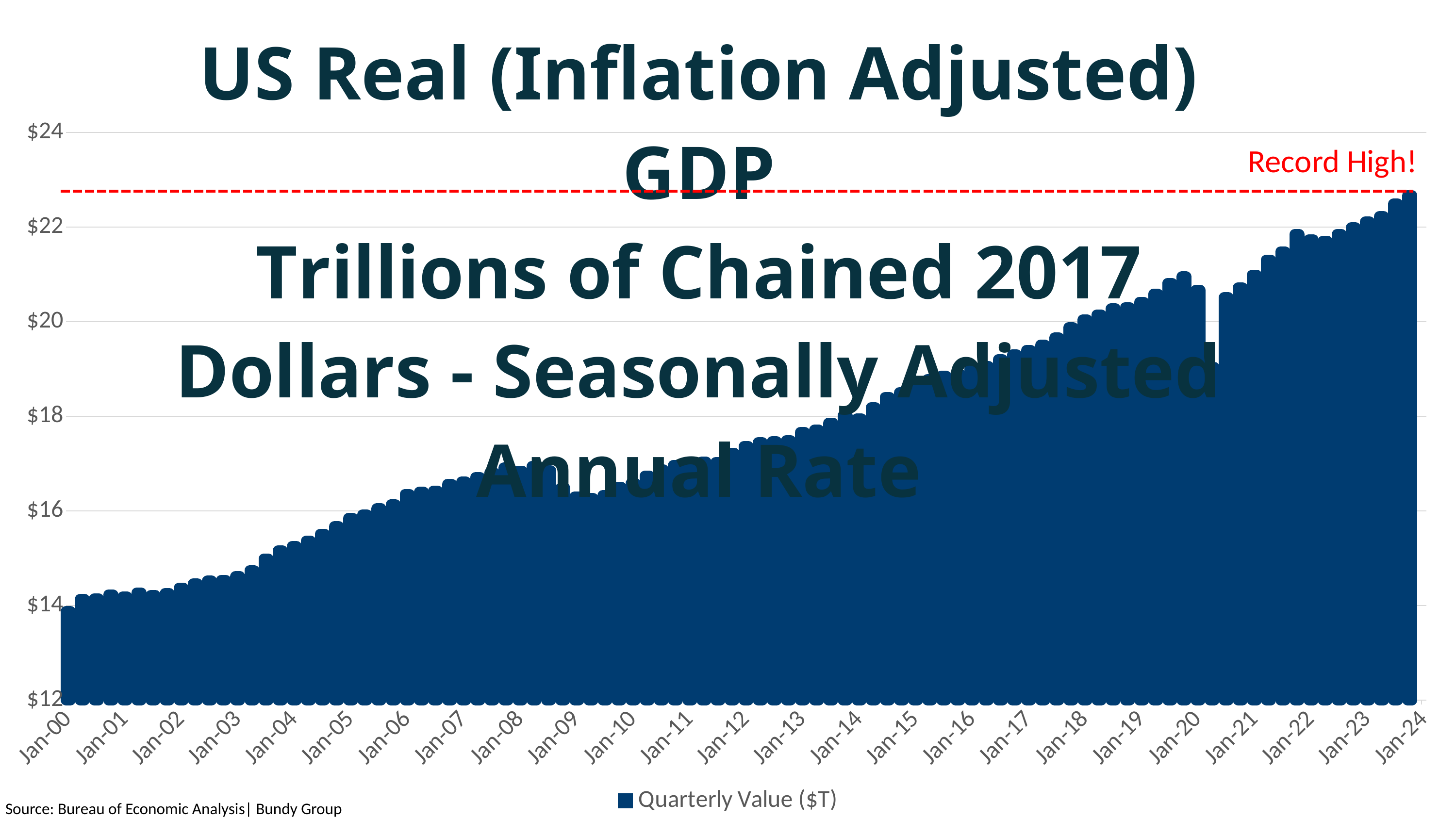
Do the quarterly GDP values generally rise or fall from Jan-00 to Jan-24? rise What kind of chart is shown on the slide? bar chart What is the legend entry for the series shown? Quarterly Value ($T) Is the value for Jan-20 greater or less than $20? greater Which date has the lowest quarterly value on the chart? Jan-00 How many series does the legend list? 1 Is the value for Jan-10 greater or less than $18? less What text is written in red next to the dashed line at the top of the chart? Record High!